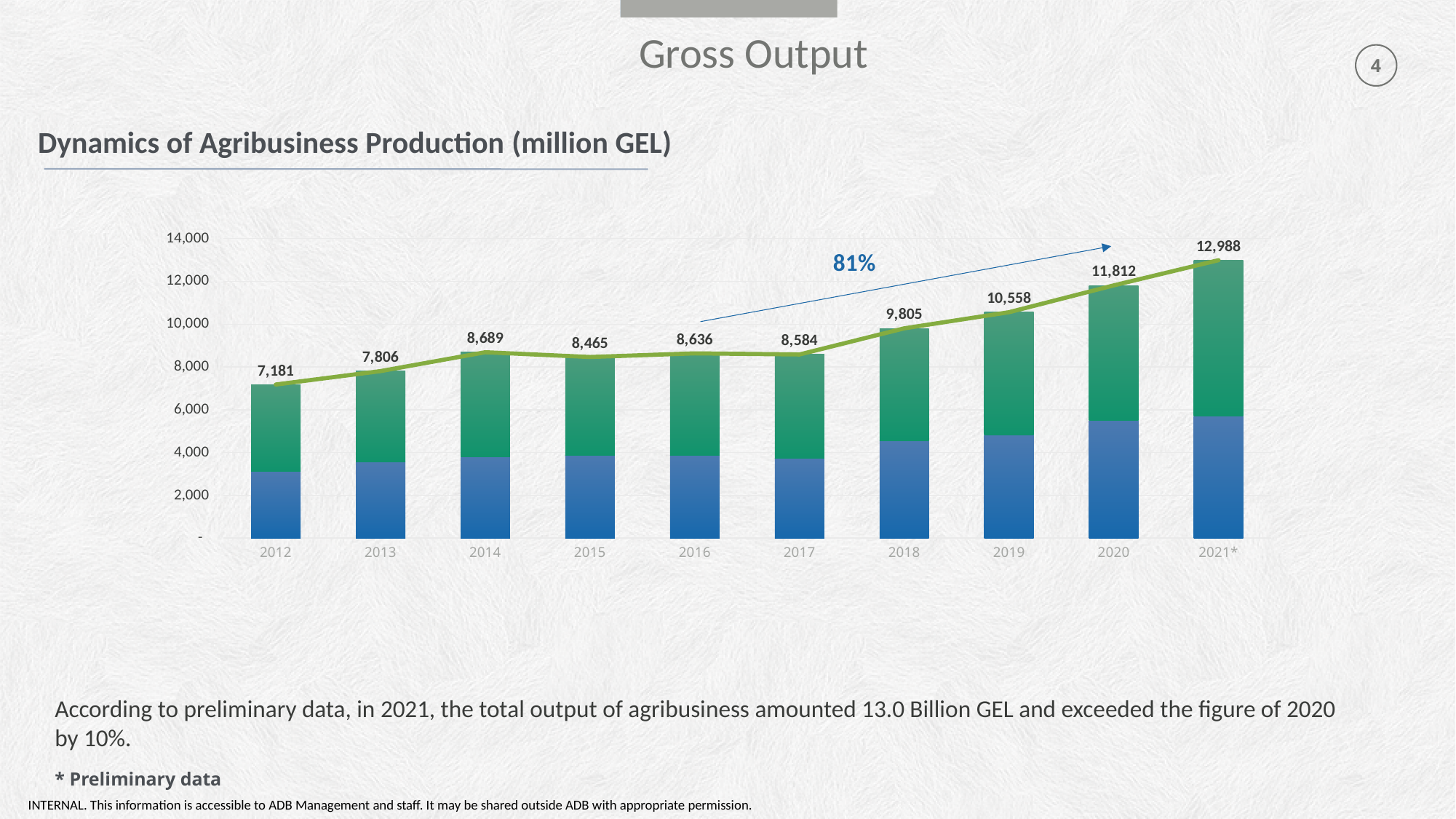
What is the total agribusiness production value shown for 2012? 7,181 How many years are shown on the x axis? 10 Which year has the highest total value? 2021* What percentage growth is annotated by the arrow on the chart? 81% What value is labelled for 2018? 9,805 By how much does the 2014 value exceed the 2013 value? 883 What is the difference between the 2021* value and the 2020 value? 1,176 Which year has the larger total value, 2015 or 2016? 2016 What kind of chart is used to show the agribusiness production data? Stacked bar chart with a line What is the value shown for 2021*? 12,988 Which year has the lowest total value? 2012 Is the blue (lower) segment of the 2012 bar greater or less than 4,000? less